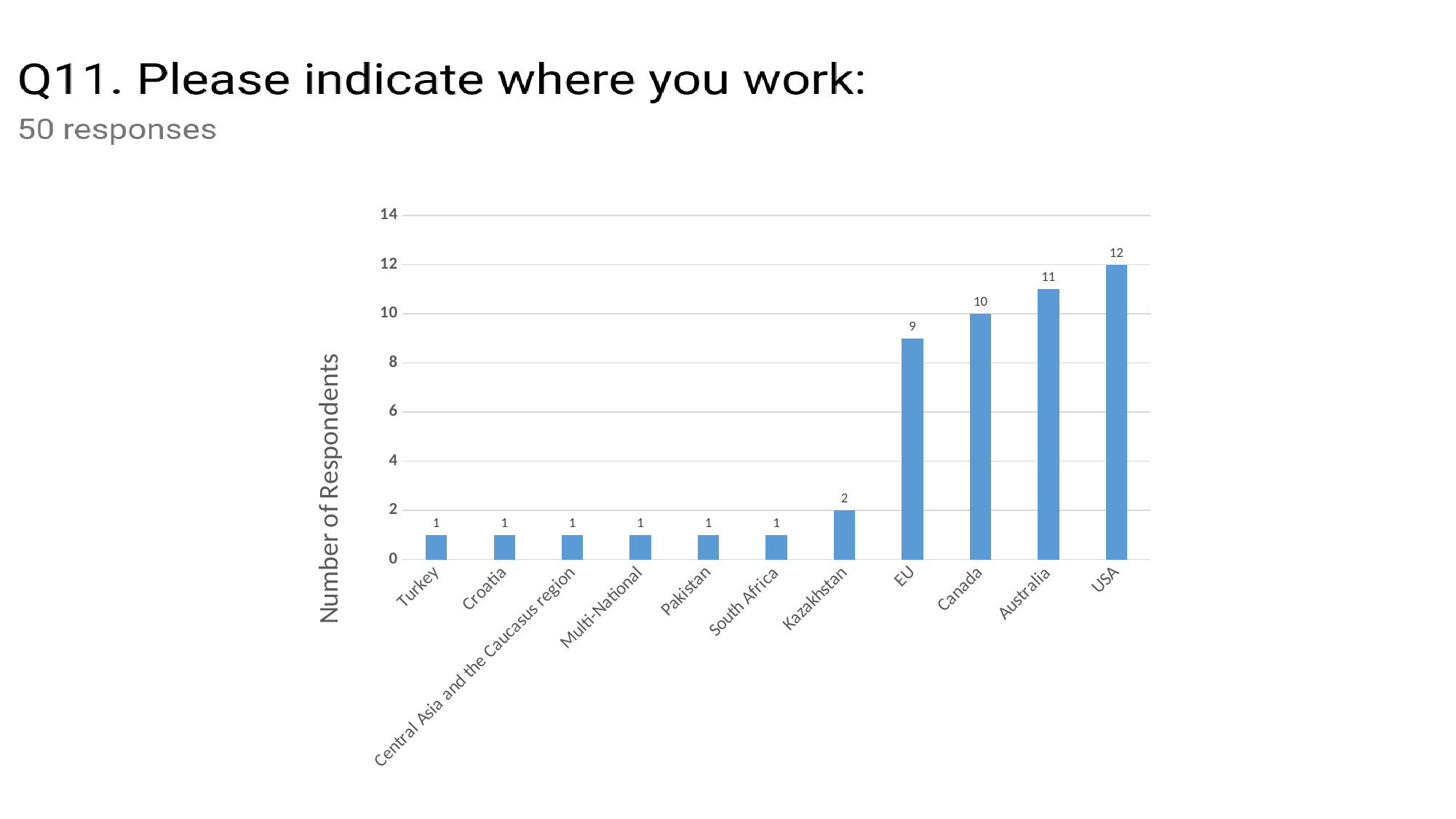
Which location has the highest number of respondents? USA What is the difference in number of respondents between the USA and the EU? 3 What is the difference in number of respondents between Australia and Kazakhstan? 9 How many locations are shown on the x axis? 11 Which has more respondents, Canada or Australia? Australia Which has more respondents, Kazakhstan or Pakistan? Kazakhstan What is the label of the vertical axis? Number of Respondents Is the value for the EU greater or less than 8? greater What kind of chart is shown on the slide? Bar chart How many respondents work in Kazakhstan? 2 How many respondents work in the USA? 12 How many respondents work in Canada? 10